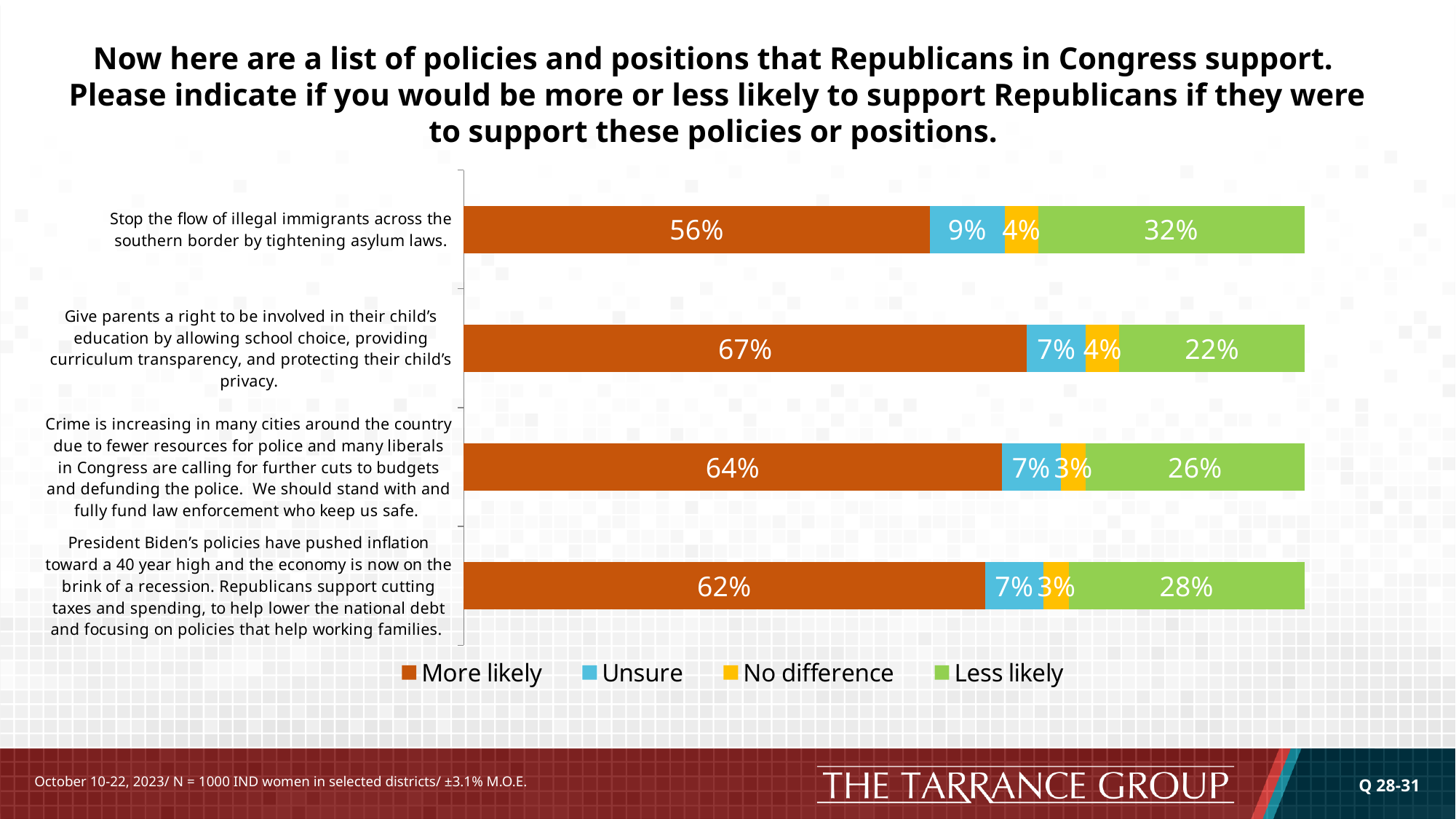
How many policies are shown in the chart? 4 What is the 'Unsure' value for the policy about stopping the flow of illegal immigrants across the southern border? 9% Which policy has the lowest 'More likely' percentage? Stop the flow of illegal immigrants across the southern border by tightening asylum laws. What percentage of respondents said they would be 'More likely' to support Republicans for the policy to stop the flow of illegal immigrants across the southern border by tightening asylum laws? 56% What type of chart is shown on the slide? Stacked horizontal bar chart Which policy has the highest 'More likely' percentage? Give parents a right to be involved in their child's education by allowing school choice, providing curriculum transparency, and protecting their child's privacy. What is the 'No difference' value for the policy about crime increasing and fully funding law enforcement? 3% What is the difference between the 'More likely' percentages for the parents' rights in education policy and the illegal immigration policy? 11 percentage points How many series does the legend list? 4 Which policy has the highest 'Less likely' percentage? Stop the flow of illegal immigrants across the southern border by tightening asylum laws. Is the 'More likely' value larger for the crime/law enforcement policy or for the inflation/economy policy? Crime/law enforcement policy (64%) What is the 'Less likely' value for the policy about giving parents a right to be involved in their child's education? 22%